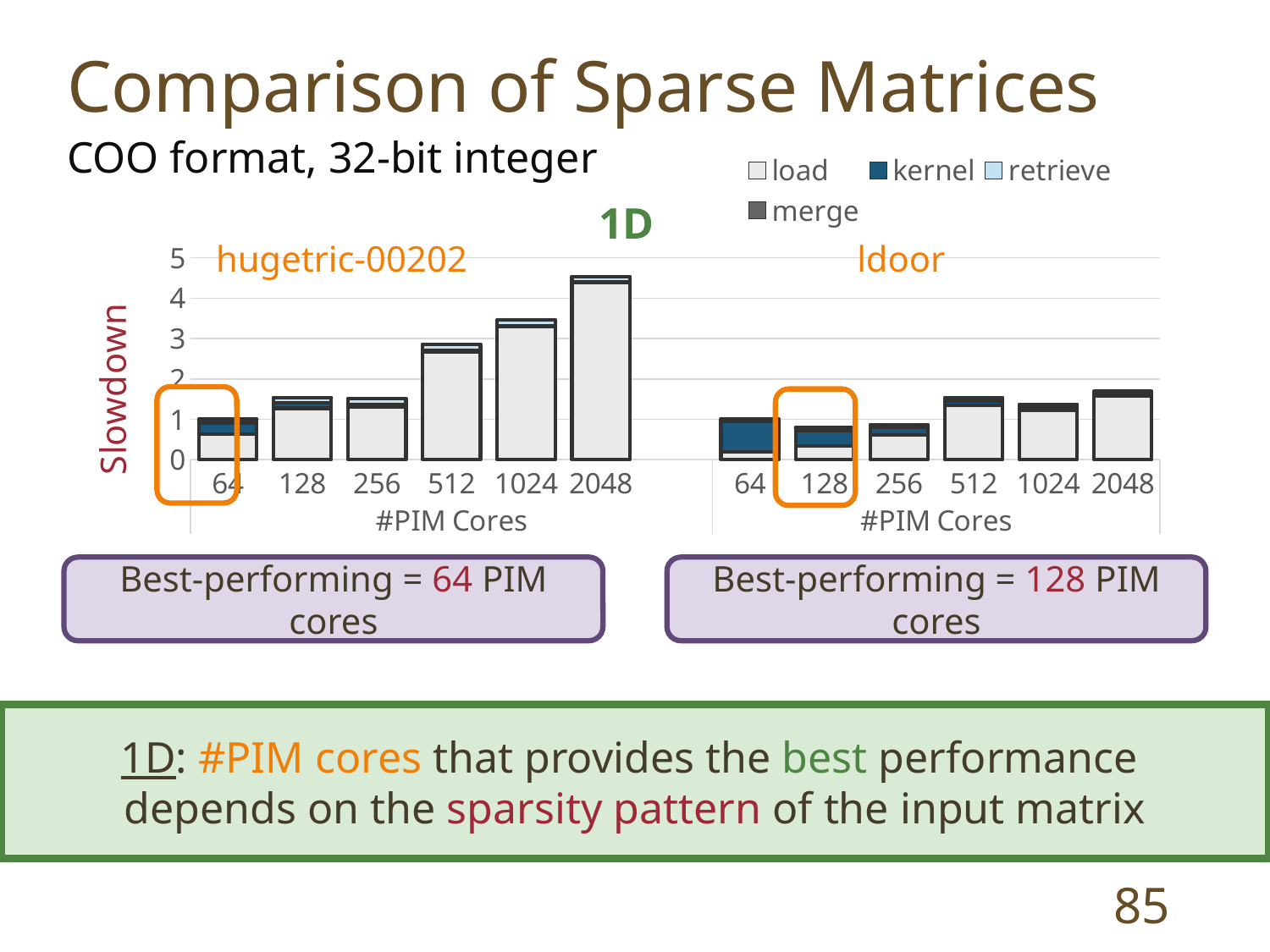
Is the slowdown for hugetric-00202 at 2048 PIM cores greater or less than 4? greater For the ldoor matrix, which #PIM Cores value has the lowest slowdown? 128 Is the slowdown for ldoor at 512 PIM cores greater or less than 2? less What kind of chart is shown on the slide? stacked bar chart How many series does the legend list? 4 For the hugetric-00202 matrix, which #PIM Cores value has the lowest slowdown? 64 How many #PIM Cores categories are plotted for the hugetric-00202 matrix? 6 For the hugetric-00202 matrix, which #PIM Cores value has the highest slowdown? 2048 Which has the larger slowdown at 2048 PIM cores: hugetric-00202 or ldoor? hugetric-00202 What is the label of the y axis? Slowdown Is the slowdown for hugetric-00202 at 1024 PIM cores greater or less than 3? greater For hugetric-00202, does the slowdown generally rise or fall as #PIM Cores increases from 64 to 2048? rise